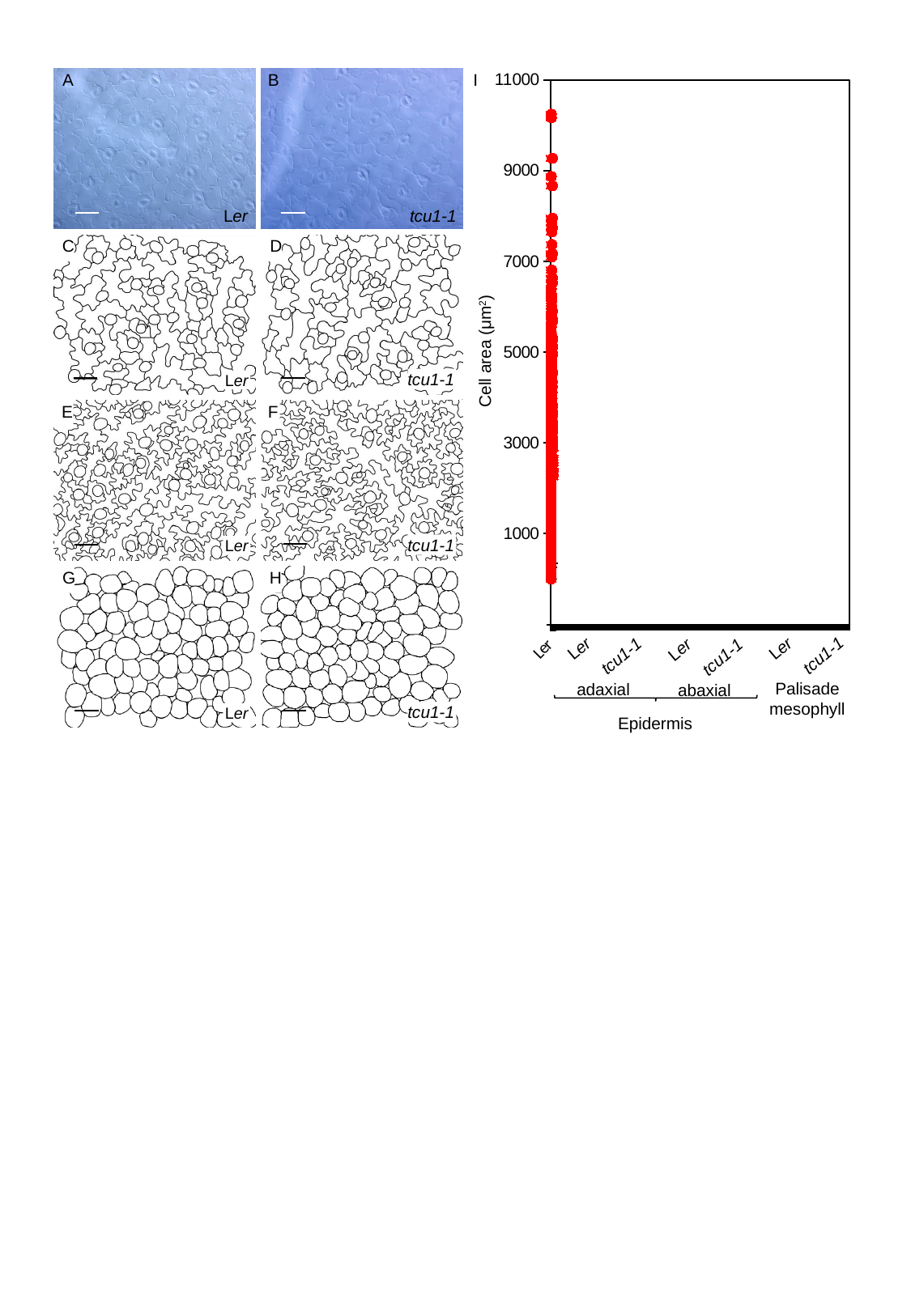
In the chart in panel I, is the highest plotted cell area value greater or less than 9000? greater How many category labels are listed along the x axis of the chart in panel I? 7 What is the highest value shown on the y axis of the chart in panel I? 11000 In the chart in panel I, is the lowest plotted cell area value greater or less than 1000? less What is the label of the y axis in the chart in panel I? Cell area (µm²) What kind of chart is panel I on the slide? scatter (dot) plot In the chart in panel I, is the highest plotted cell area value greater or less than 11000? less